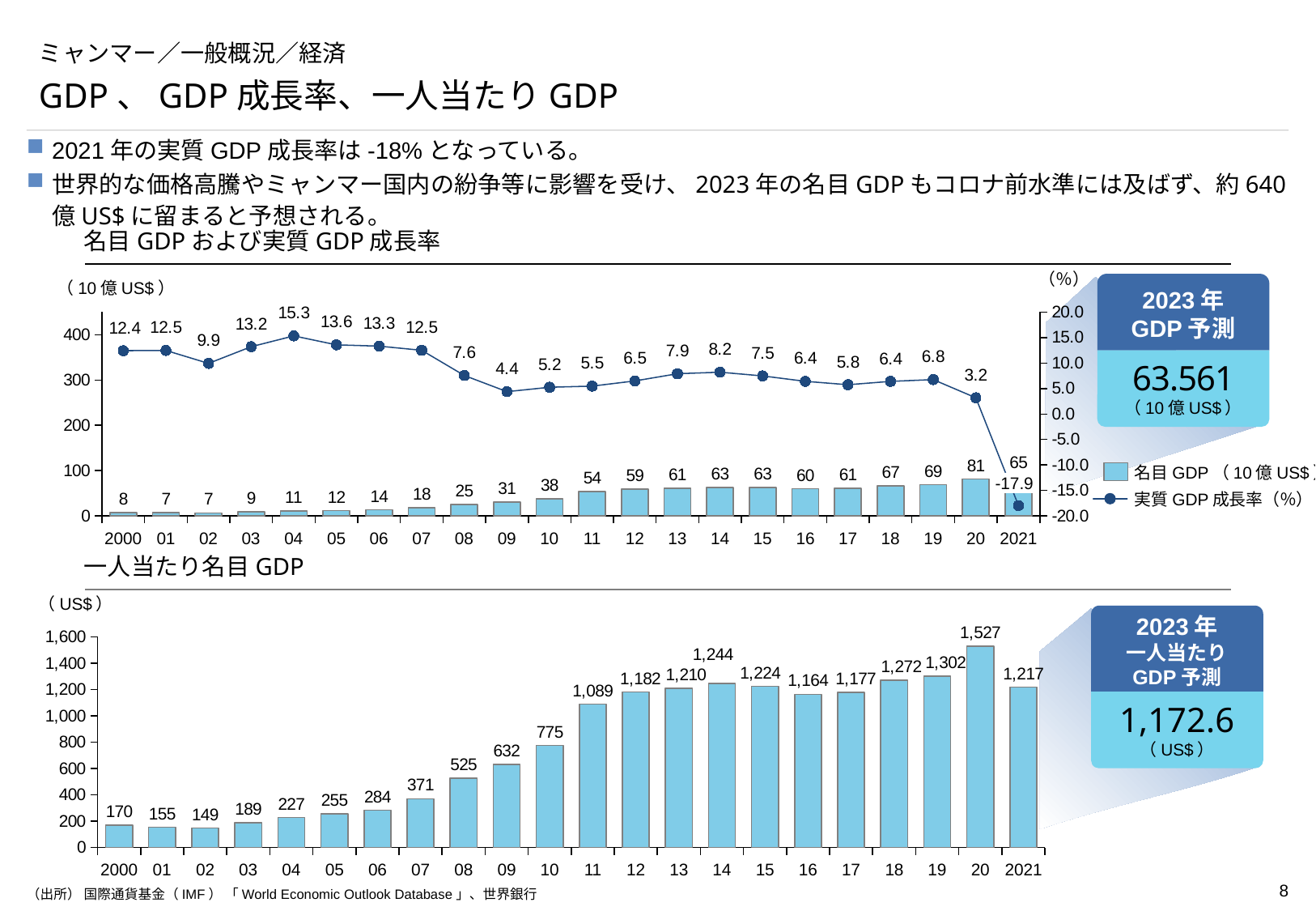
In the top chart (名目GDPおよび実質GDP成長率), what is the nominal GDP value for 2020? 81 In the top chart (名目GDPおよび実質GDP成長率), is the real GDP growth rate for 2009 greater or less than the rate for 2008? less What is the 2023 per-capita GDP forecast value shown in the box next to the bottom chart? 1,172.6 In the bottom chart (一人当たり名目GDP), how many years are plotted? 22 In the top chart (名目GDPおよび実質GDP成長率), how many series does the legend list? 2 In the bottom chart (一人当たり名目GDP), what is the value for 2020? 1,527 In the bottom chart (一人当たり名目GDP), which year has the lowest value? 02 In the top chart (名目GDPおよび実質GDP成長率), which year has the highest real GDP growth rate? 04 In the top chart (名目GDPおよび実質GDP成長率), what is the real GDP growth rate for 2021? -17.9 In the bottom chart (一人当たり名目GDP), what is the difference between the values for 2020 and 2021? 310 What kind of chart is the bottom chart (一人当たり名目GDP)? bar chart In the top chart (名目GDPおよび実質GDP成長率), what is the difference between the nominal GDP of 2020 and 2021? 16